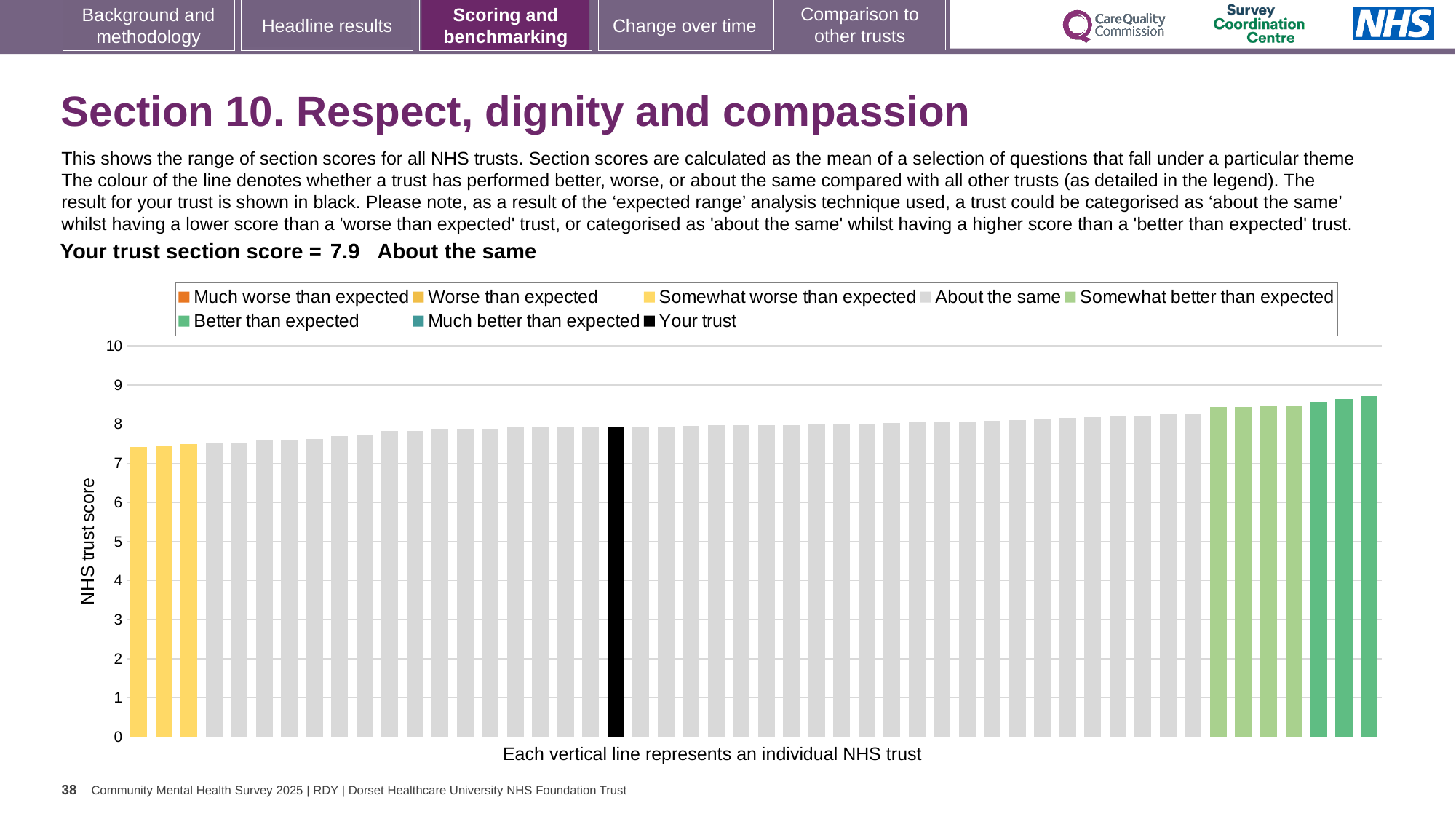
How many entries does the chart legend list? 8 How many bars are coloured as 'Somewhat worse than expected' (yellow)? 3 What is the label on the y axis of the chart? NHS trust score Is the value of the rightmost (highest) bar greater or less than 9? less What is the section score for your trust shown on the slide? 7.9 Which is larger: the rightmost bar or the black 'Your trust' bar? the rightmost bar Do the bar values rise or fall from left to right along the x axis? rise Is the value of the leftmost (lowest) bar greater or less than 7? greater Is the value of the black 'Your trust' bar greater or less than 5? greater What kind of chart is shown on the slide? bar chart Which category does your trust fall into for this section? About the same How many bars are coloured as 'Better than expected' (dark green)? 3